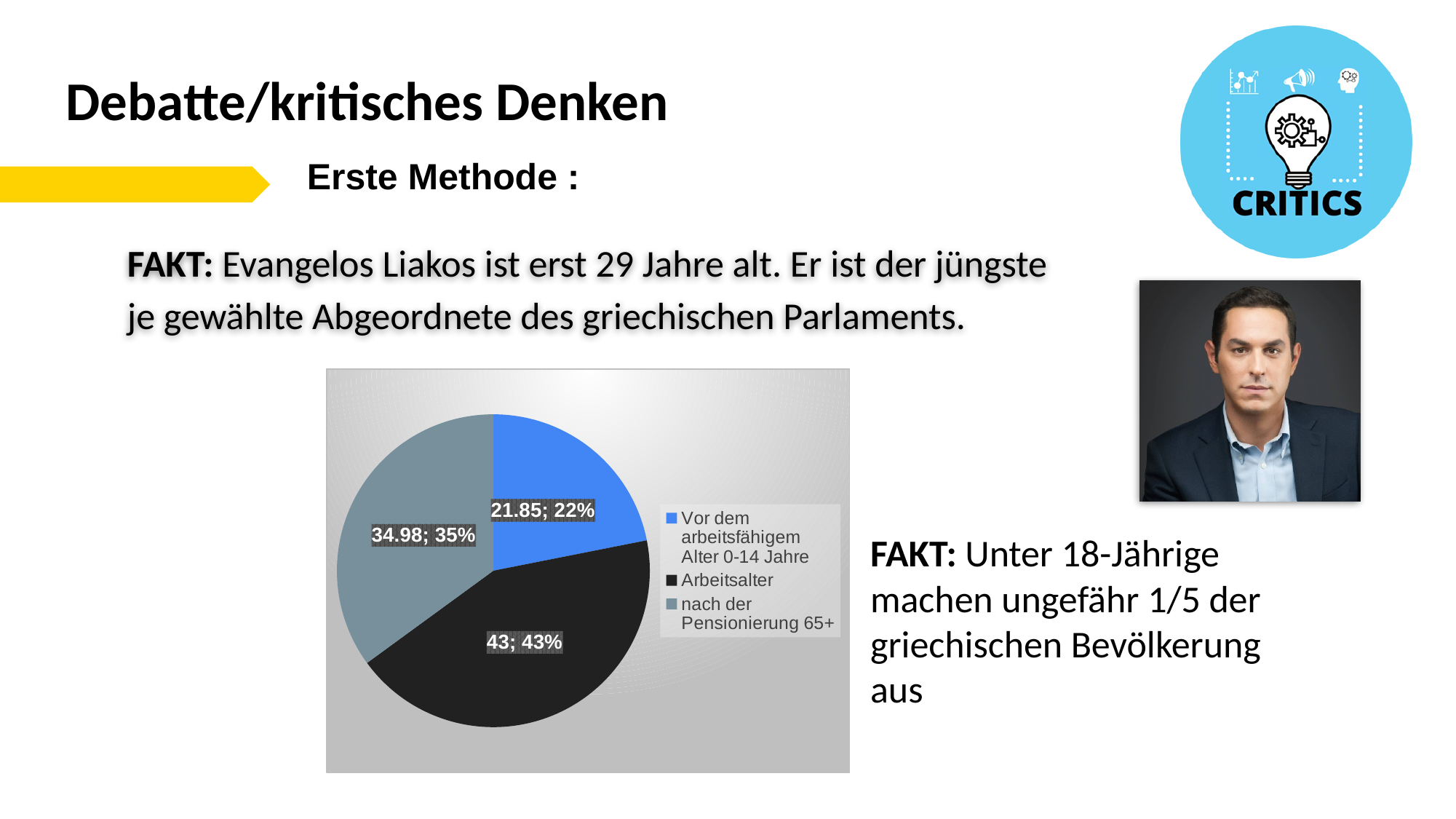
What value is labelled on the slice for "Vor dem arbeitsfähigem Alter 0-14 Jahre"? 21.85; 22% What percentage share of the pie does "nach der Pensionierung 65+" have? 35% What value is labelled on the slice for "Arbeitsalter"? 43; 43% What colour is the slice for "Vor dem arbeitsfähigem Alter 0-14 Jahre"? blue How many slices does the pie chart have? 3 What value is labelled on the slice for "nach der Pensionierung 65+"? 34.98; 35% How many entries does the legend of the pie chart list? 3 Which is larger, the slice for "Arbeitsalter" or the slice for "nach der Pensionierung 65+"? Arbeitsalter What kind of chart is shown on the slide? pie chart Which category has the largest slice of the pie chart? Arbeitsalter Which category has the smallest slice of the pie chart? Vor dem arbeitsfähigem Alter 0-14 Jahre What is the difference in percentage points between the "Arbeitsalter" slice and the "Vor dem arbeitsfähigem Alter 0-14 Jahre" slice? 21%